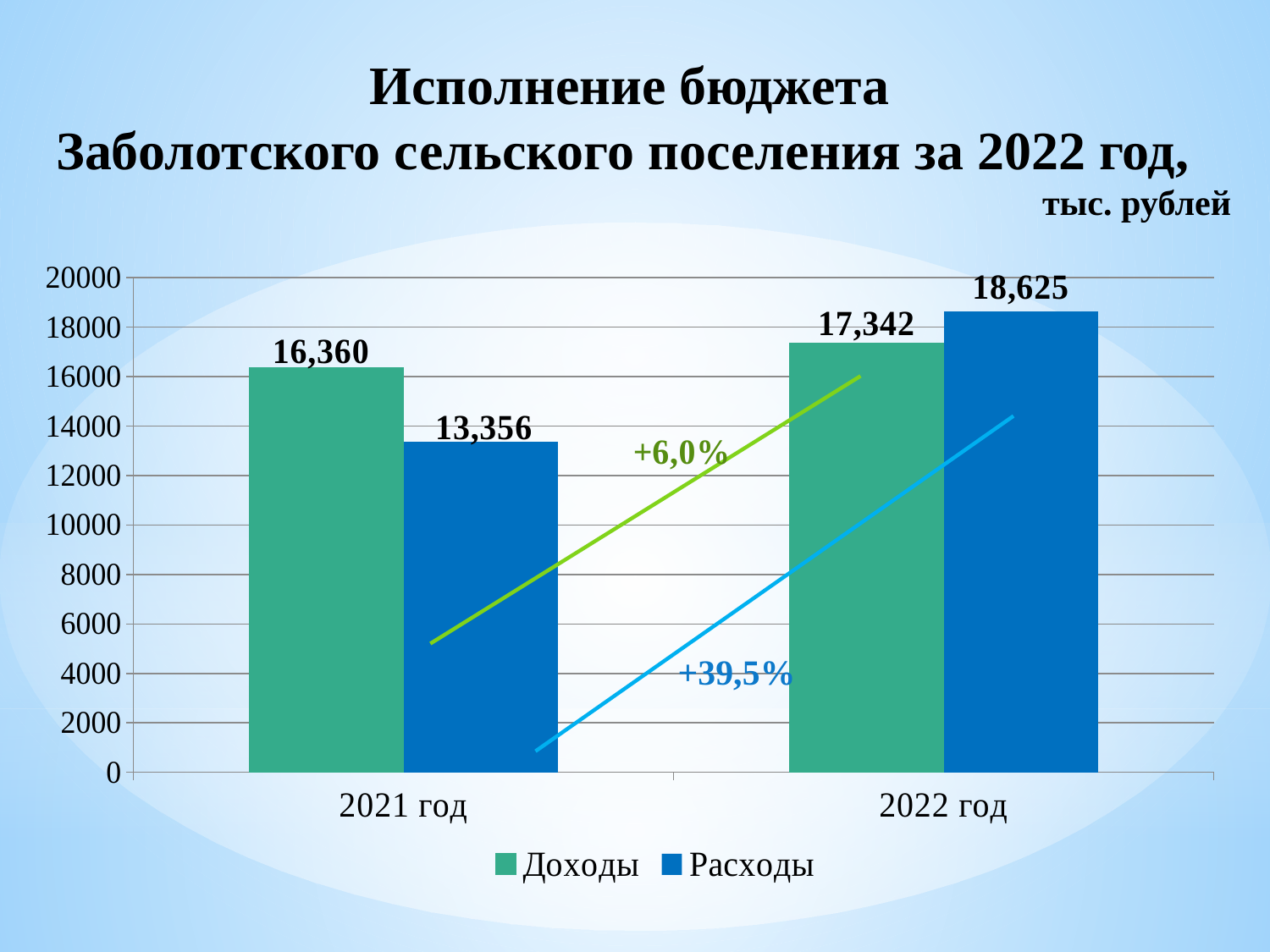
What is the value of Доходы for 2021 год? 16,360 How many series does the legend list? 2 What is the value of Расходы for 2021 год? 13,356 What is the difference between Доходы and Расходы in 2021 год? 3,004 Which bar has the lowest value on the chart? Расходы, 2021 год What percentage change is annotated for Расходы between 2021 год and 2022 год? +39,5% Which is larger in 2022 год, Доходы or Расходы? Расходы Which bar has the highest value on the chart? Расходы, 2022 год What kind of chart is shown on the slide? Bar chart What is the value of Доходы for 2022 год? 17,342 What is the value of Расходы for 2022 год? 18,625 By how much did Доходы increase from 2021 год to 2022 год? 982